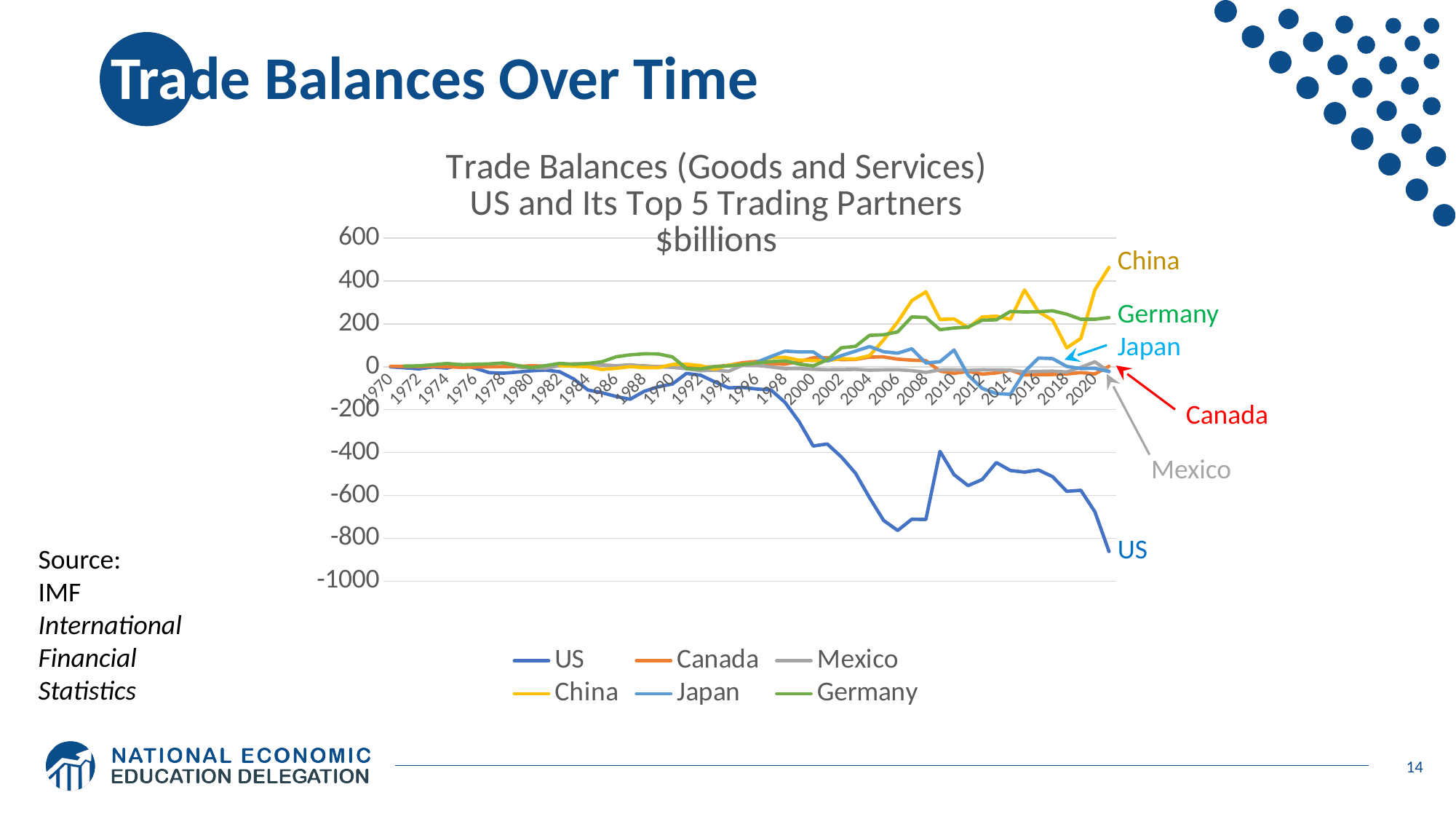
Is the value for the US in 2020 greater or less than -800? greater Is the value for the US in 2006 greater or less than -600? less What kind of chart is shown on the slide? line chart How many series does the legend list? 6 Is the value for China in 2020 greater or less than 400? less Which country's line has the lowest value in 2020? US Which country's line has the highest value in 2020? China Does the US line rise or fall between 1998 and 2006? fall What is the first year shown on the x axis? 1970 In 2020, which is larger, the value for China or the value for Germany? China What unit is stated in the chart title? $billions